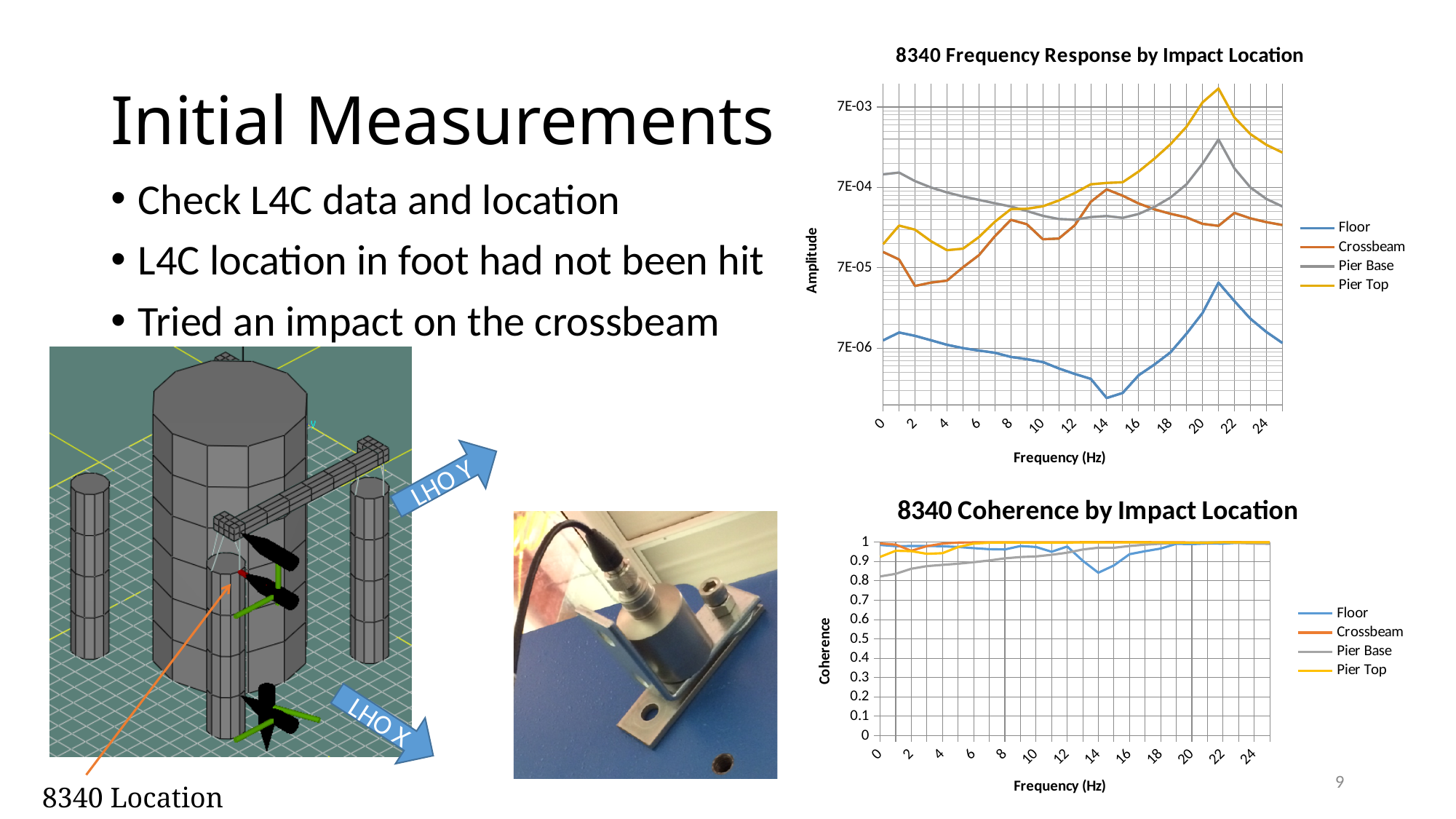
In the '8340 Frequency Response by Impact Location' chart, which is larger at 2 Hz, Pier Base or Crossbeam? Pier Base In the '8340 Coherence by Impact Location' chart, does the Pier Base series rise or fall as frequency increases from 0 to 24 Hz? rise In the '8340 Frequency Response by Impact Location' chart, which series has the highest amplitude at 22 Hz? Pier Top In the '8340 Coherence by Impact Location' chart, which series has the lowest coherence at 0 Hz? Pier Base In the '8340 Frequency Response by Impact Location' chart, is the peak Pier Top value near 21 Hz greater or less than 7E-03? greater In the '8340 Frequency Response by Impact Location' chart, is the Pier Base value at 0 Hz greater or less than 7E-04? greater What kind of chart is the '8340 Frequency Response by Impact Location' chart? line chart In the '8340 Frequency Response by Impact Location' chart, is the Floor value at 14 Hz greater or less than 7E-06? less In the '8340 Frequency Response by Impact Location' chart, which series has the lowest amplitude across the frequency range? Floor How many series does the legend of the '8340 Frequency Response by Impact Location' chart list? 4 What kind of chart is the '8340 Coherence by Impact Location' chart? line chart